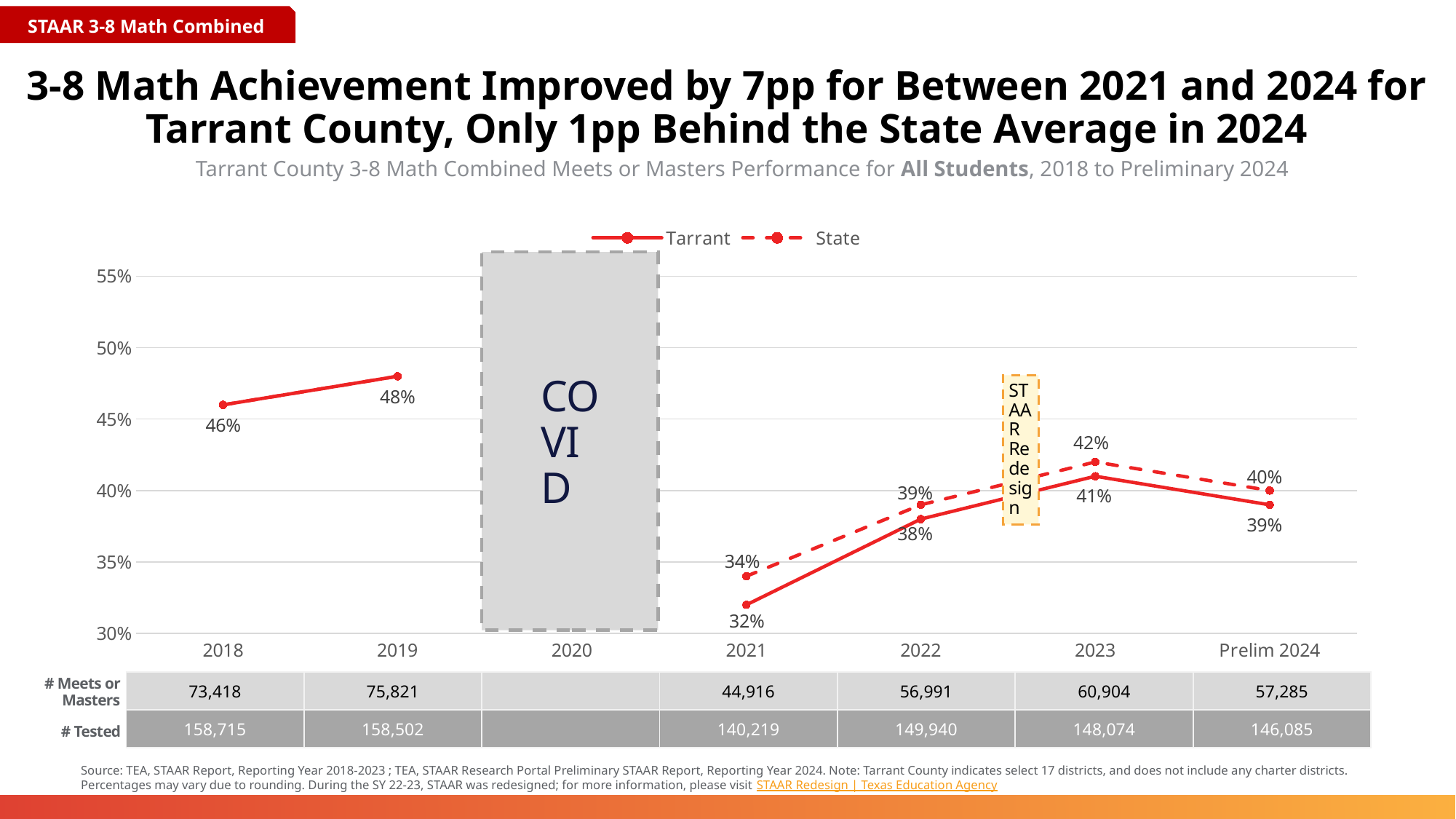
How many series does the chart legend list? 2 What is the Tarrant value for 2021? 32% Which is larger in 2022, the Tarrant value or the State value? State In which year is the Tarrant value highest? 2019 How does the Tarrant value change from 2021 to 2023? It rises What is the Tarrant value for Prelim 2024? 39% In which year is the Tarrant value lowest? 2021 What is the State value for 2023? 42% Which series is drawn with a dashed line? State What type of chart is shown on the slide? line chart What is the difference between the Tarrant values for 2019 and 2021? 16 percentage points According to the table, how many students were tested in 2022? 149,940